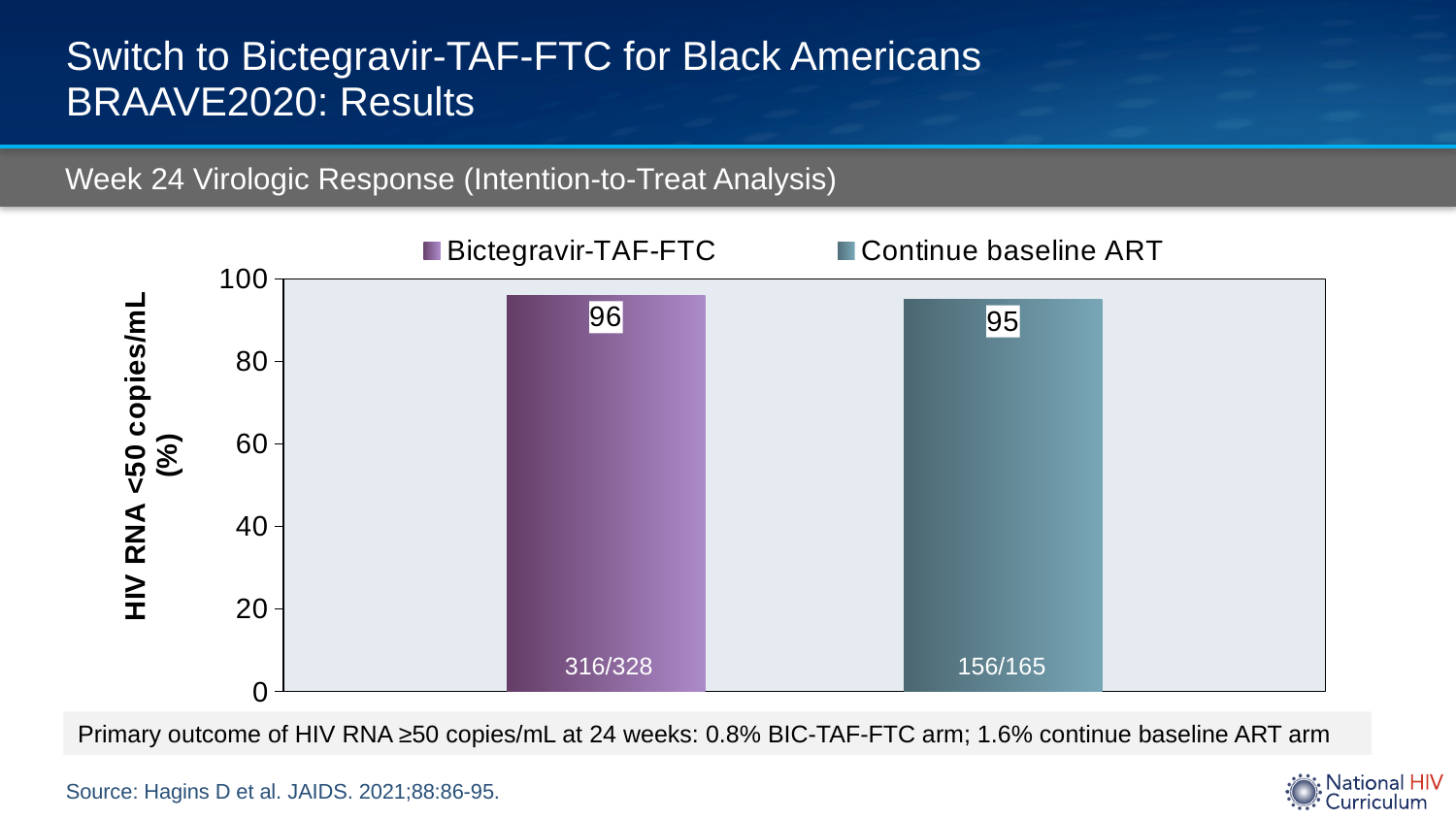
What is the value for Bictegravir-TAF-FTC? 96 What fraction is printed inside the Continue baseline ART bar? 156/165 Which series has the lower value? Continue baseline ART What is the y-axis label of the chart? HIV RNA <50 copies/mL (%) What kind of chart is shown? bar chart What fraction is printed inside the Bictegravir-TAF-FTC bar? 316/328 Which series has the higher value? Bictegravir-TAF-FTC How many series does the legend list? 2 What is the value for Continue baseline ART? 95 What is the difference between the Bictegravir-TAF-FTC value and the Continue baseline ART value? 1 Is the value for Continue baseline ART greater or less than 80? greater What is the title of the chart? Week 24 Virologic Response (Intention-to-Treat Analysis)